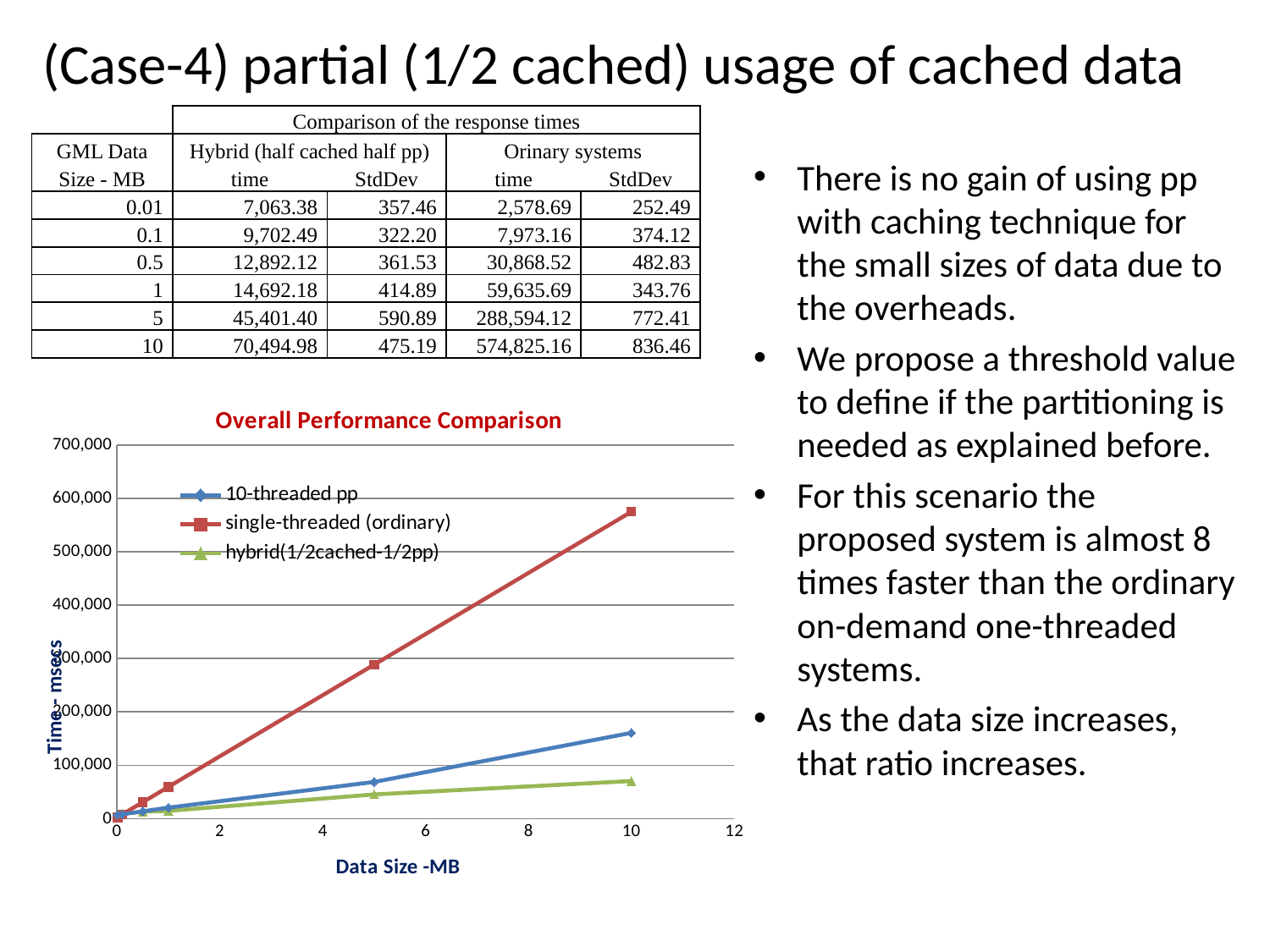
In the "Overall Performance Comparison" chart, is the value for hybrid(1/2cached-1/2pp) at 10 MB greater or less than 100,000? less In the "Overall Performance Comparison" chart, is the value for single-threaded (ordinary) at 10 MB greater or less than 500,000? greater In the "Overall Performance Comparison" chart, which series has the highest value at 10 MB? single-threaded (ordinary) In the "Overall Performance Comparison" chart, is the value for 10-threaded pp at 10 MB greater or less than 200,000? less In the "Overall Performance Comparison" chart, which series has the lowest value at 10 MB? hybrid(1/2cached-1/2pp) In the "Overall Performance Comparison" chart, does the single-threaded (ordinary) series rise or fall as data size increases? rise What is the title of the chart on the slide? Overall Performance Comparison In the "Overall Performance Comparison" chart, which is higher at 10 MB: single-threaded (ordinary) or hybrid(1/2cached-1/2pp)? single-threaded (ordinary) What is the x-axis title of the "Overall Performance Comparison" chart? Data Size -MB How many series does the legend of the "Overall Performance Comparison" chart list? 3 What kind of chart is the "Overall Performance Comparison" chart? line chart